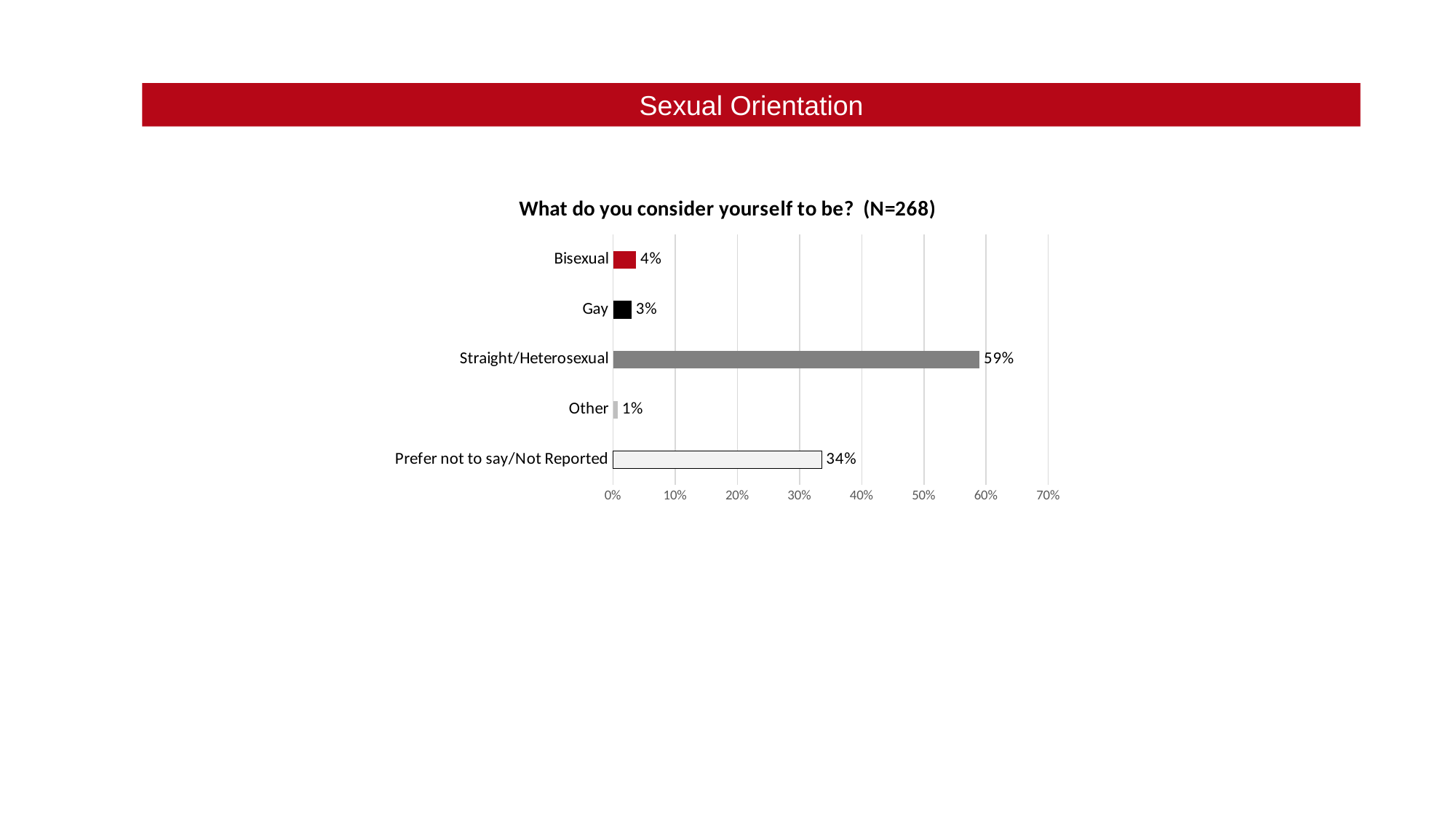
What type of chart is shown on the slide? Bar chart What percentage of respondents identified as Straight/Heterosexual? 59% What percentage of respondents identified as Bisexual? 4% Which is larger, the percentage for Bisexual or the percentage for Gay? Bisexual What percentage of respondents identified as Gay? 3% Which category has the highest percentage? Straight/Heterosexual What is the sample size (N) stated in the chart title? 268 What percentage of respondents chose Prefer not to say/Not Reported? 34% How many categories are shown in the chart? 5 Which category has the lowest percentage? Other Is the value for Prefer not to say/Not Reported greater or less than 30%? greater What is the difference in percentage points between Straight/Heterosexual and Prefer not to say/Not Reported? 25